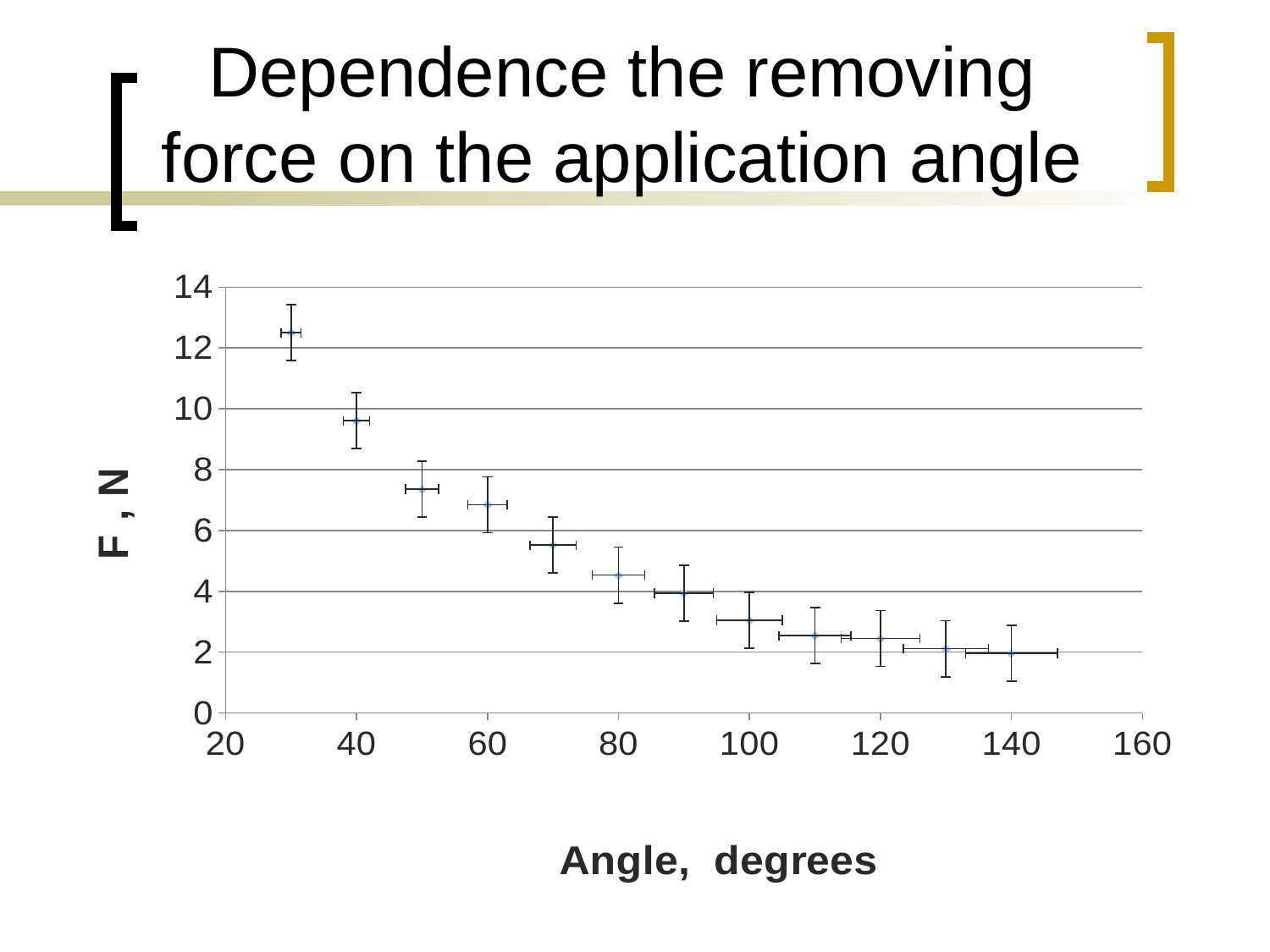
How many data points are plotted on the chart? 12 What is the label of the x axis? Angle, degrees Which has the larger force F: 40 degrees or 60 degrees? 40 degrees Is the value of F at 40 degrees greater or less than 10? less At which angle is the force F highest? 30 degrees What kind of chart is shown on the slide? scatter chart Is the value of F at 80 degrees greater or less than 4? greater Is the value of F at 110 degrees greater or less than 2? greater Do the force values rise or fall as the angle increases along the x axis? fall What is the label of the y axis? F , N